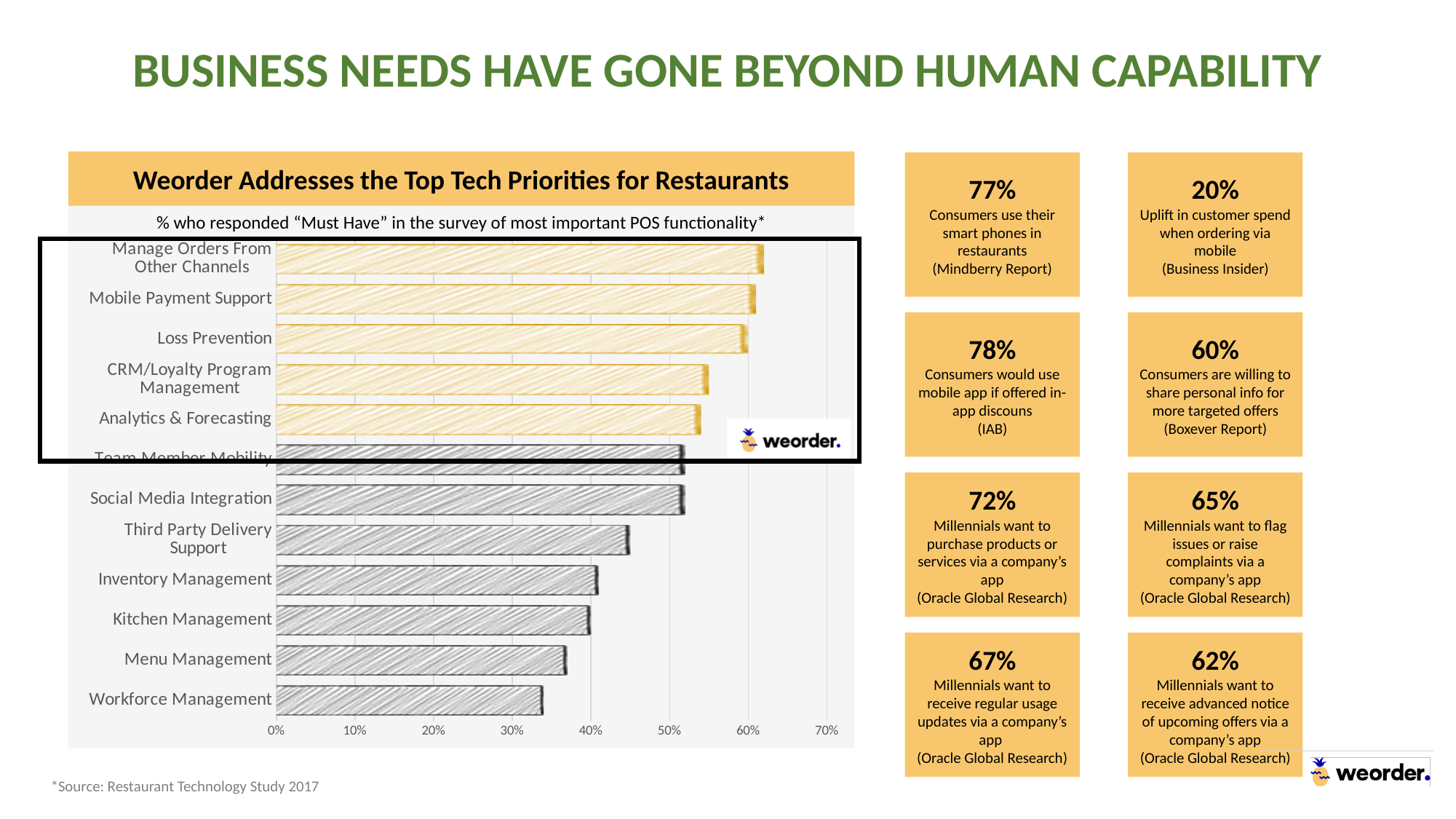
Is the value for Menu Management greater or less than 40%? less Which category has the lowest value in the chart? Workforce Management Which category has the highest value in the chart? Manage Orders From Other Channels What is the title of the chart? Weorder Addresses the Top Tech Priorities for Restaurants Is the value for Manage Orders From Other Channels greater or less than 50%? greater Which is larger, the value for Mobile Payment Support or the value for Inventory Management? Mobile Payment Support What kind of chart is shown on the slide? bar chart Is the value for Third Party Delivery Support greater or less than 40%? greater How many categories are plotted in the chart? 12 Which is larger, the value for Third Party Delivery Support or the value for Menu Management? Third Party Delivery Support